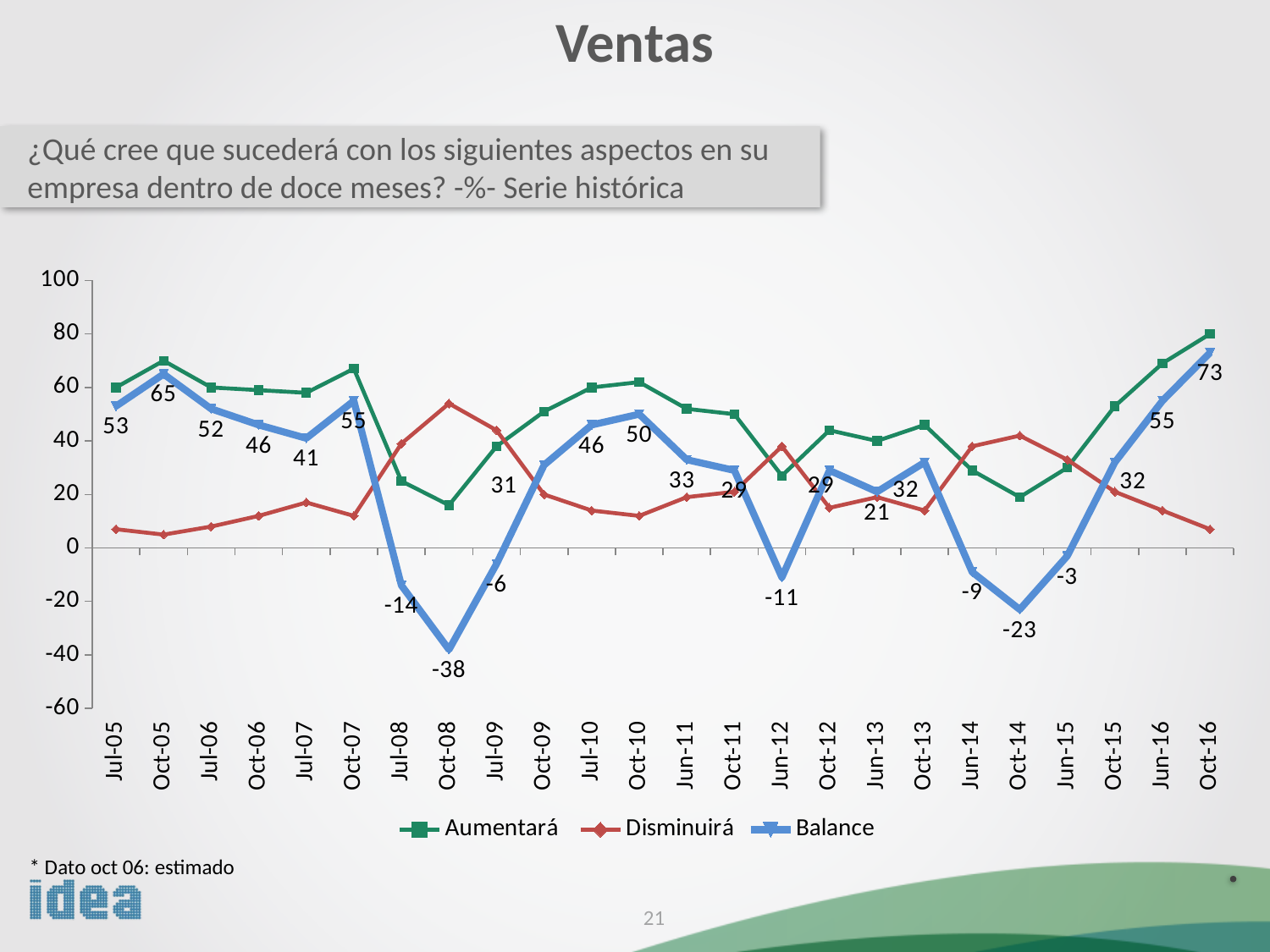
How many series does the legend list? 3 What is the Balance value for Oct-08? -38 What is the Balance value for Oct-14? -23 What is the Balance value for Oct-16? 73 What kind of chart is shown on the slide? Line chart At which date does the Balance series reach its highest value? Oct-16 How many dates are shown on the x axis? 24 At which date does the Balance series reach its lowest value? Oct-08 Is the Disminuirá value for Oct-08 greater or less than 40? greater Is the Aumentará value for Oct-16 greater or less than 60? greater Which is larger, the Balance value for Oct-05 or for Oct-10? Oct-05 What is the difference between the Balance values for Oct-16 and Jun-16? 18